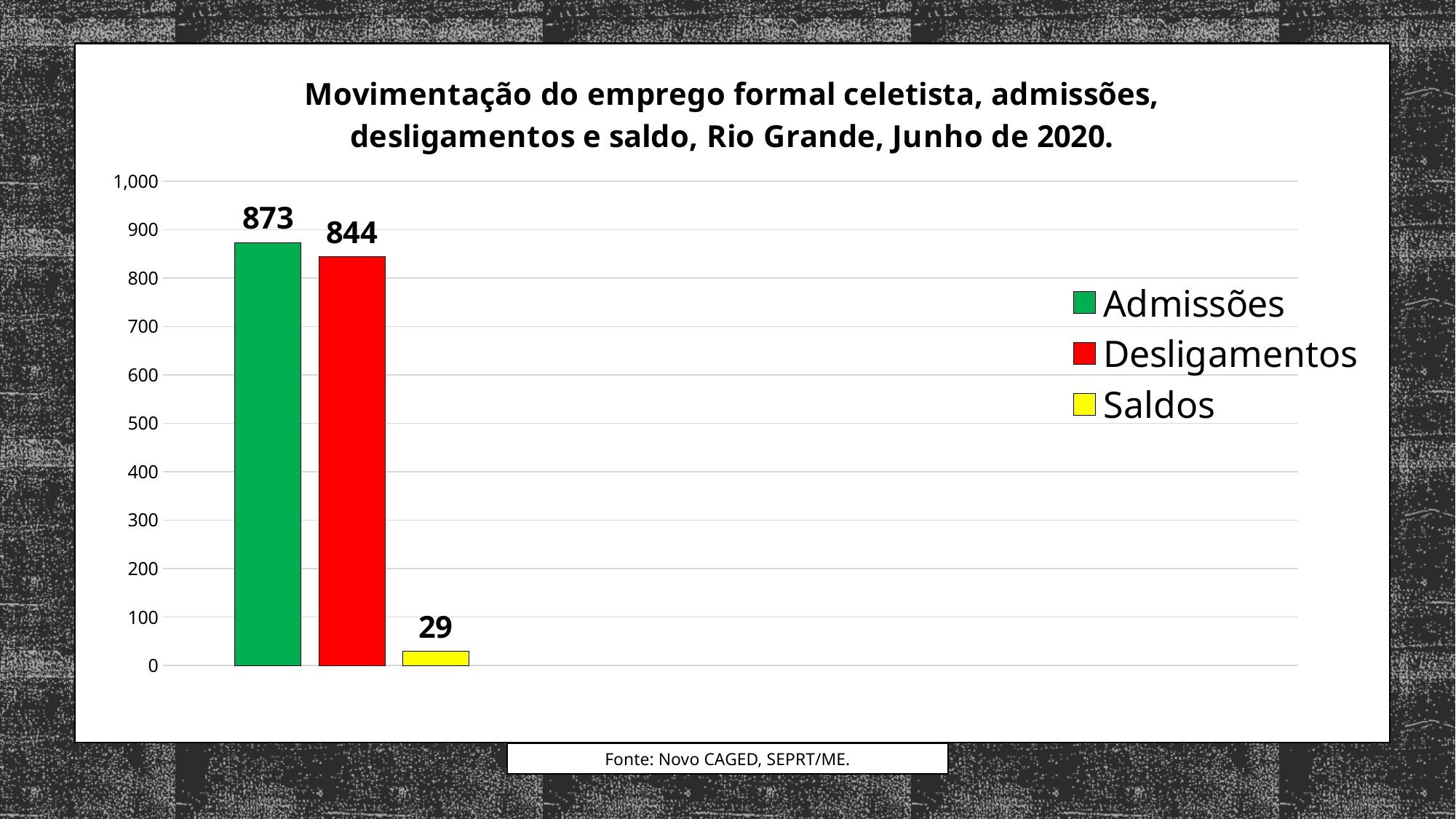
How many bars are plotted on the chart? 3 What is the value for Saldos? 29 Is the value for Desligamentos greater or less than 800? greater What kind of chart is shown on the slide? bar chart Which is larger, Desligamentos or Saldos? Desligamentos How many series does the legend list? 3 What is the value for Desligamentos? 844 What is the value for Admissões? 873 What colour is the bar for Saldos? yellow Which series has the lowest value? Saldos What is the difference between Admissões and Desligamentos? 29 Which series has the highest value? Admissões